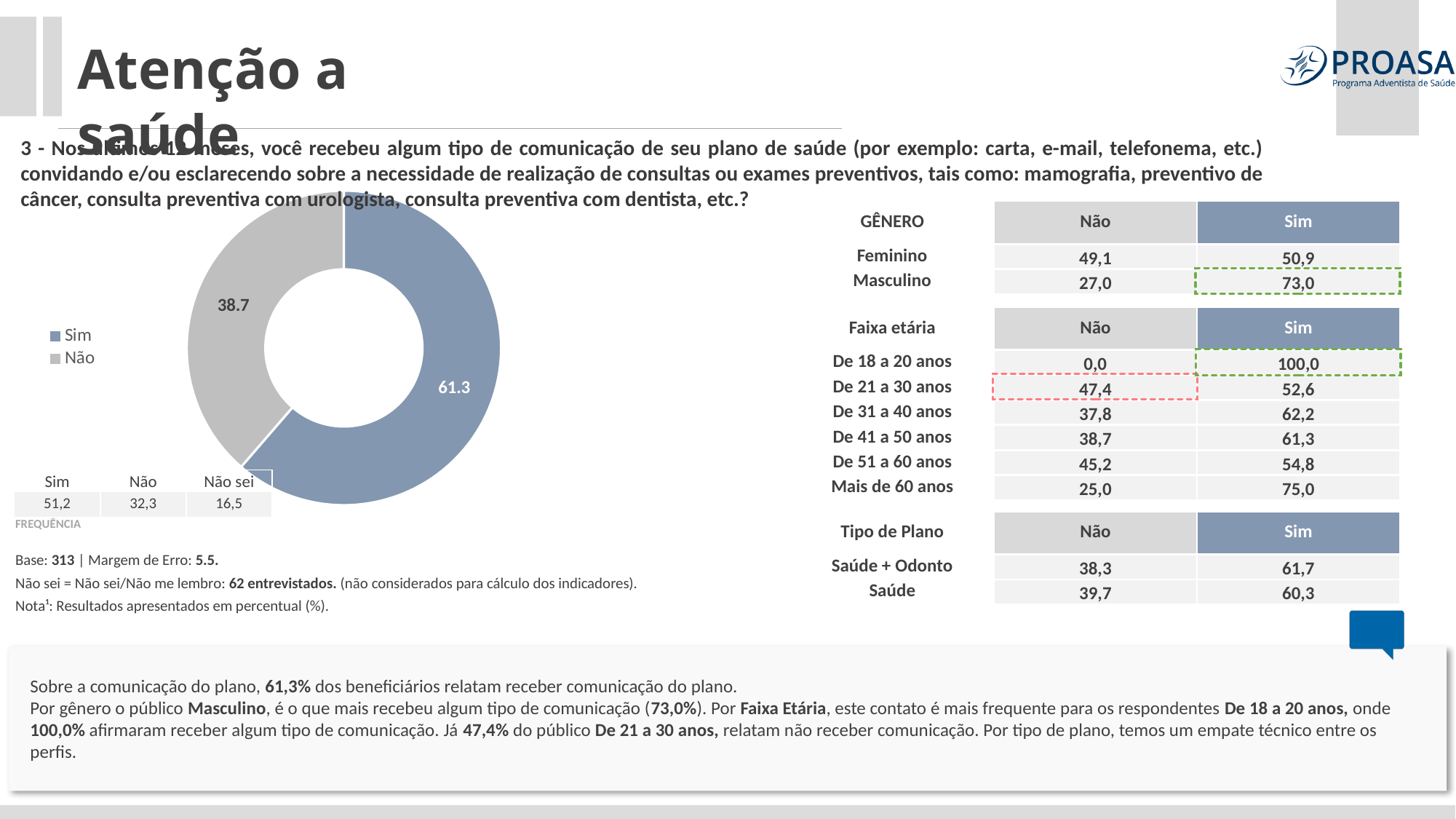
Which slice of the donut chart is the largest? Sim In the donut chart, what is the value shown for "Não"? 38.7 What colour is the "Sim" slice in the donut chart? Blue Which slice of the donut chart is the smallest? Não How many slices does the donut chart have? 2 In the donut chart, what is the difference between the "Sim" value and the "Não" value? 22.6 In the donut chart, which is larger: "Sim" or "Não"? Sim In the donut chart, is the value for "Sim" greater or less than 50? greater How many entries does the legend of the donut chart list? 2 What kind of chart is shown on the left of the slide? Donut (pie) chart What share of the donut chart does the "Sim" slice represent? 61.3% In the donut chart, what is the value shown for "Sim"? 61.3